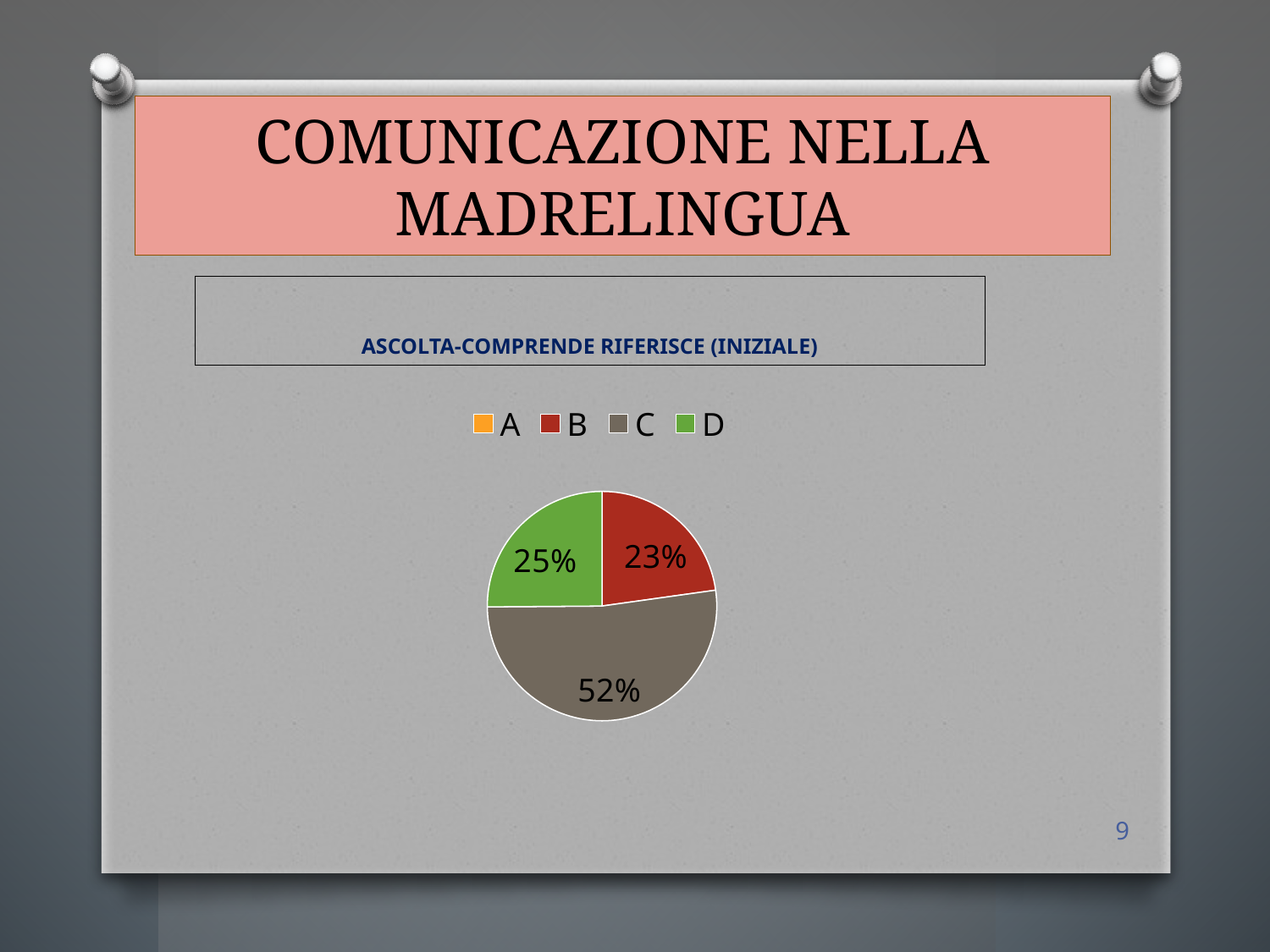
What is the title of the chart? ASCOLTA-COMPRENDE RIFERISCE (INIZIALE) Which labelled slice of the pie is the smallest? B Which category has the largest slice of the pie? C What type of chart is shown on the slide? pie chart How many slices with percentage labels are visible in the pie? 3 What percentage is shown for category D? 25% What percentage is shown for category C? 52% What is the difference in percentage points between category C and category B? 29% Which is larger, the slice for B or the slice for D? D What percentage is shown for category B? 23% How many entries does the chart legend list? 4 What colour is the slice for category C? grey-brown